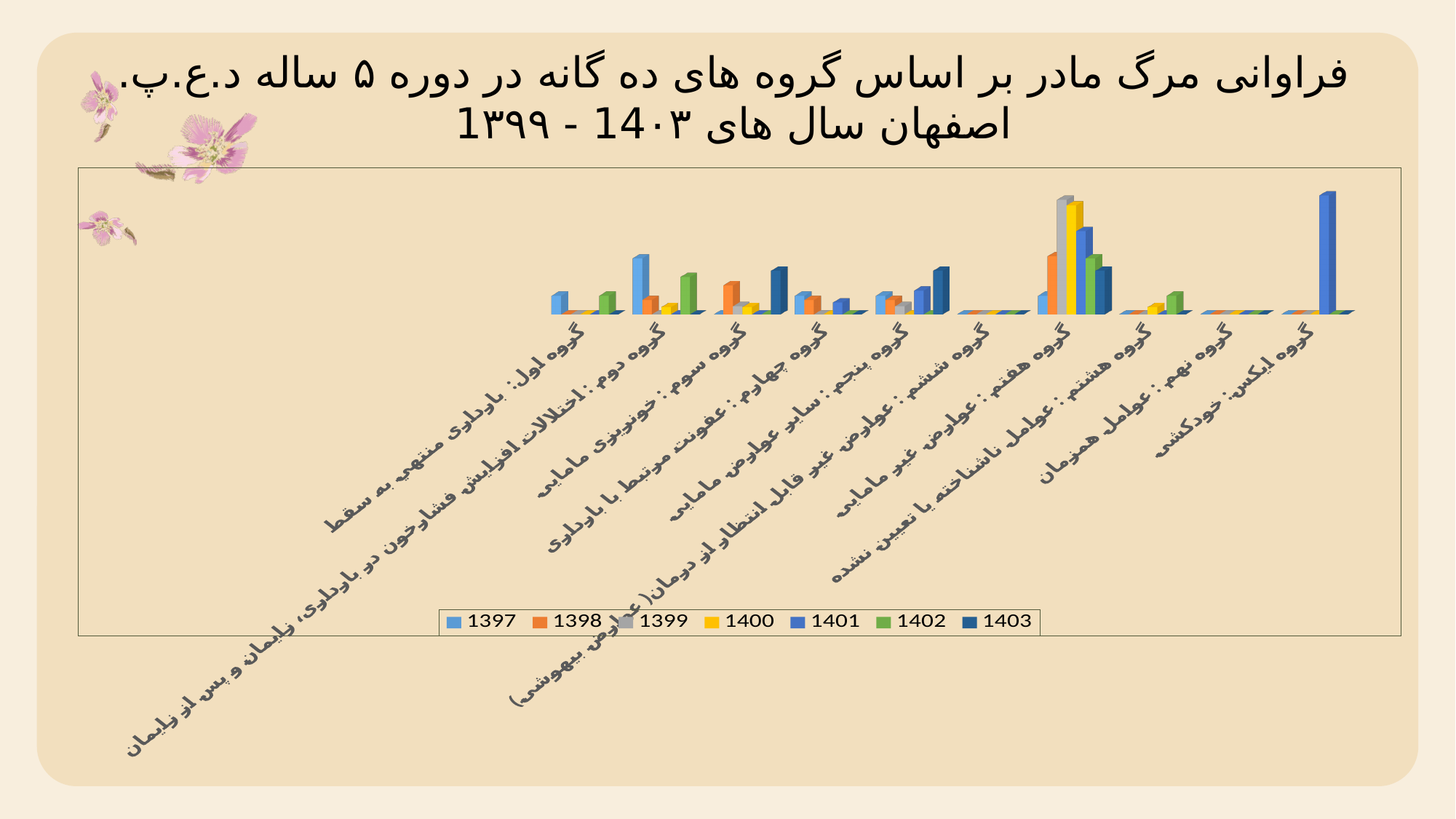
Which category has the tallest bar for the series 1397? گروه دوم: اختلالات افزایش فشارخون در بارداری، زایمان و پس از زایمان Which series has the shortest bar in the category گروه هفتم: عوارض غیر مامایی? 1397 In the category گروه دوم, which is larger: the bar for 1397 or the bar for 1398? 1397 How many categories (groups) are shown on the x axis? 10 Which category has the tallest bar for the series 1398? گروه هفتم: عوارض غیر مامایی Which category has the tallest bar for the series 1402? گروه هفتم: عوارض غیر مامایی What kind of chart is shown on the slide? bar chart Which colour represents the series 1400 in the legend? yellow Which years are listed in the legend? 1397, 1398, 1399, 1400, 1401, 1402, 1403 For the series 1401, which is larger: the bar for گروه ششم or the bar for گروه هفتم? گروه هفتم How many series does the legend list? 7